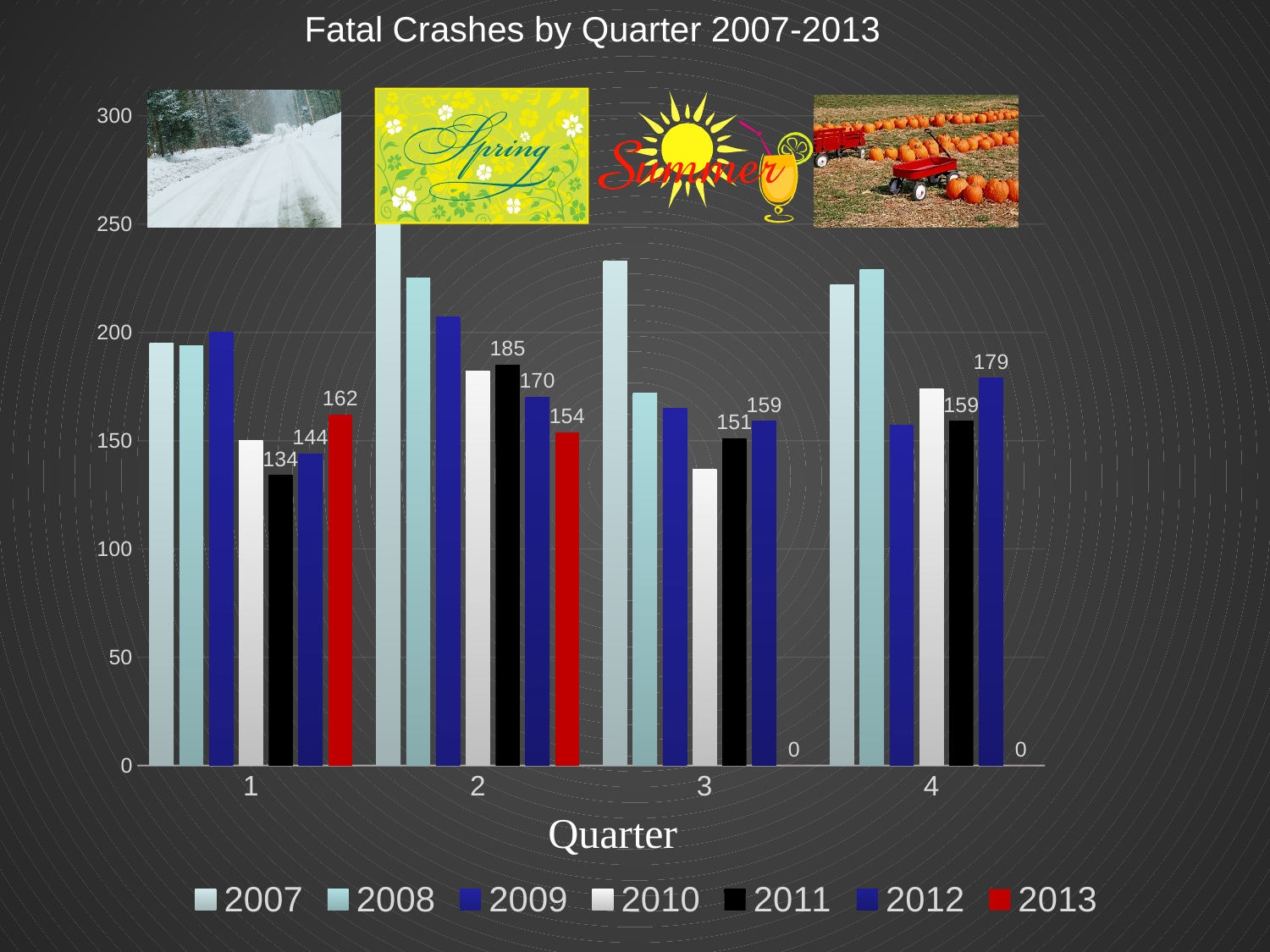
In Quarter 1, which is larger: the value for 2012 or the value for 2013? 2013 Is the value for 2007 in Quarter 1 greater or less than 150? greater What is the value for 2012 in Quarter 4? 179 In which quarter is the 2011 value highest? 2 What is the value for 2013 in Quarter 3? 0 What is the value for 2013 in Quarter 1? 162 What kind of chart is shown on the slide? Bar chart What is the difference between the 2012 and 2011 values in Quarter 4? 20 Is the value for 2010 in Quarter 3 greater or less than 150? less How many series does the legend list? 7 What is the value for 2011 in Quarter 2? 185 What is the difference between the 2011 and 2012 values in Quarter 2? 15